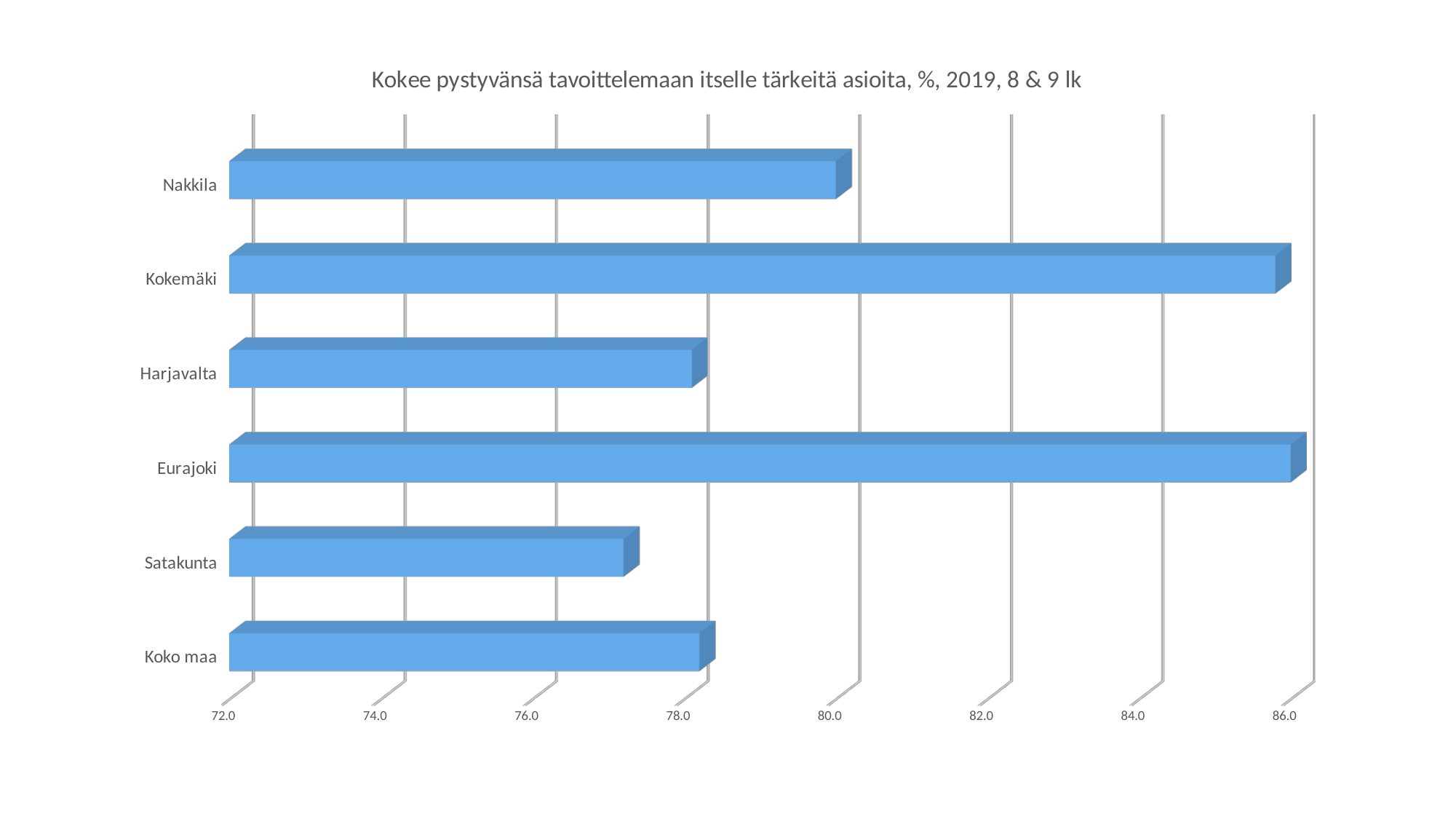
Is the value for Satakunta greater or less than 78.0? less Is the value for Eurajoki greater or less than 84.0? greater Which has the larger value, Nakkila or Harjavalta? Nakkila Is the value for Nakkila greater or less than 78.0? greater Which category has the lowest value? Satakunta What colour are the bars in the chart? Blue How many categories are shown on the chart? 6 Which has the larger value, Satakunta or Kokemäki? Kokemäki What is the title of the chart? Kokee pystyvänsä tavoittelemaan itselle tärkeitä asioita, %, 2019, 8 & 9 lk What kind of chart is shown on the slide? Bar chart